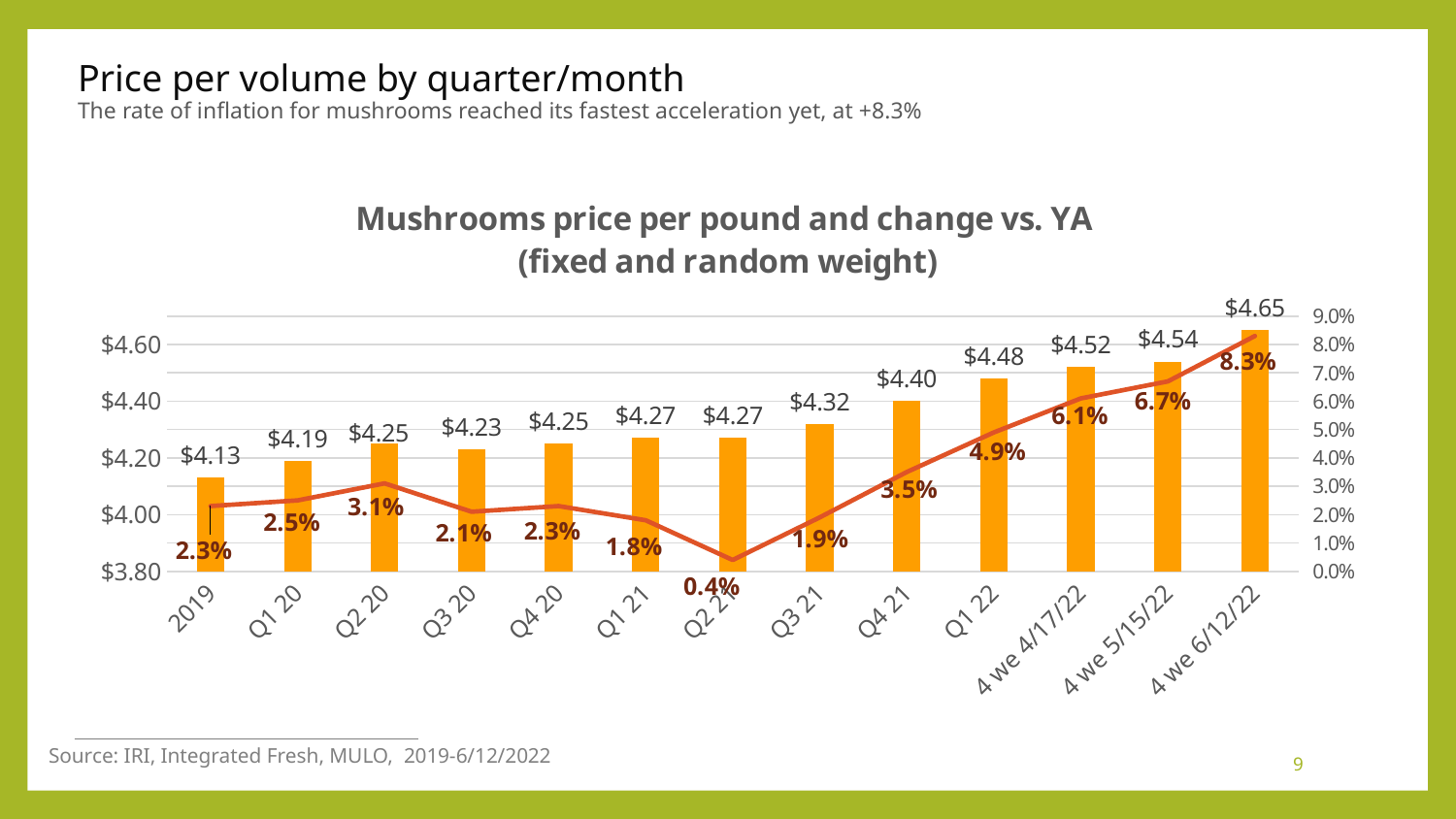
What is the difference in price per pound between 4 we 6/12/22 and 2019? $0.52 What is the price per pound for the 4 we 6/12/22 period? $4.65 Does the price per pound generally rise or fall from Q3 21 to 4 we 6/12/22? Rise How many periods are shown on the x axis? 13 Which period has the lowest price per pound? 2019 What kind of chart is this? Bar chart with a line Which is larger, the change vs. YA for Q1 22 or for Q4 21? Q1 22 What is the change vs. YA shown for Q2 21? 0.4% What is the title of the chart? Mushrooms price per pound and change vs. YA (fixed and random weight) Which period has the highest change vs. YA? 4 we 6/12/22 Which period has the lowest change vs. YA? Q2 21 What is the mushrooms price per pound for Q4 21? $4.40